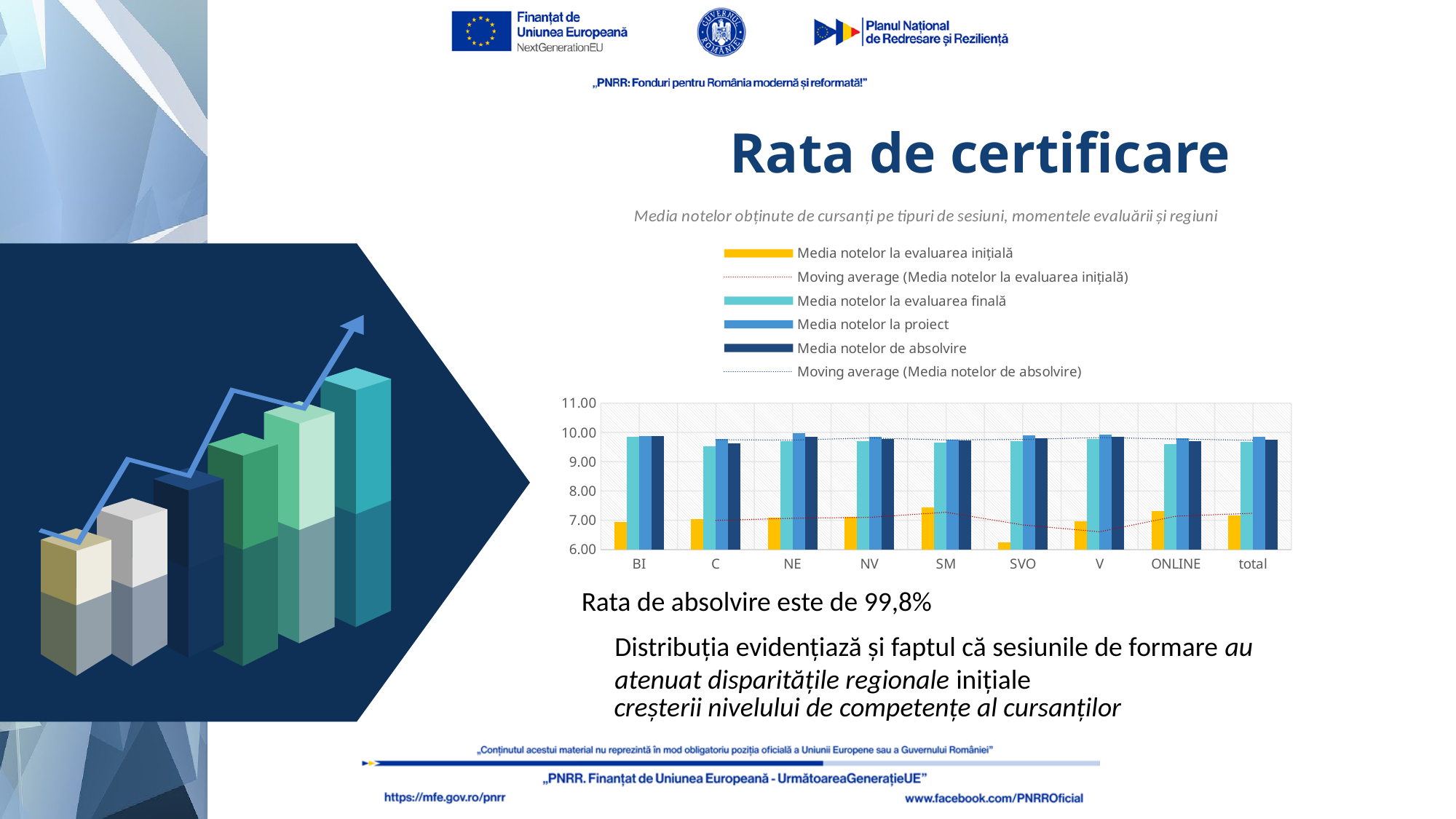
How many categories are shown along the x axis of the chart? 9 Is the value of 'Media notelor la evaluarea inițială' for SM greater or less than 7.00? greater For BI, which is larger: 'Media notelor la evaluarea inițială' or 'Media notelor la evaluarea finală'? Media notelor la evaluarea finală How many entries does the chart legend list? 6 Is the value of 'Media notelor la evaluarea inițială' for ONLINE greater or less than 7.00? greater For 'Media notelor la evaluarea inițială', which is larger: SM or SVO? SM Which category has the lowest value for 'Media notelor la evaluarea inițială'? SVO What is the title of the chart? Media notelor obținute de cursanți pe tipuri de sesiuni, momentele evaluării și regiuni Is the value of 'Media notelor la evaluarea inițială' for SVO greater or less than 7.00? less What kind of chart is shown on the slide? bar chart What is the highest value shown on the chart's y axis? 11.00